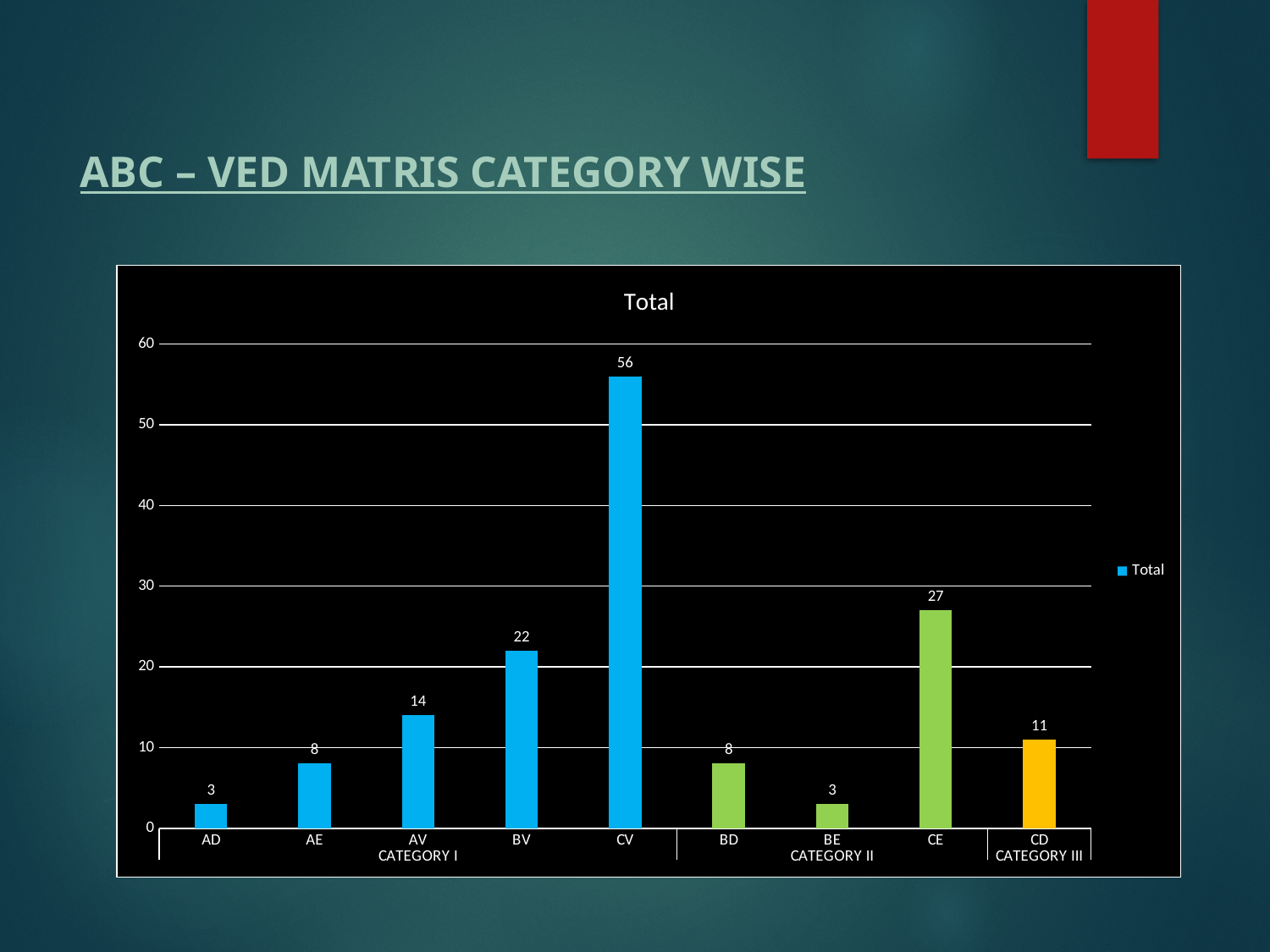
What is the difference between the values for BV and AV? 8 Is the value for CE greater or less than 30? less Which category has the highest value? CV What kind of chart is shown on the slide? bar chart How many series does the legend list? 1 What is the value for CV? 56 How many bars are plotted in the chart? 9 What is the value for CD? 11 Which is larger, the value for AV or the value for CD? AV What is the value for CE? 27 What is the difference between the values for CV and CE? 29 What is the title of the chart? Total